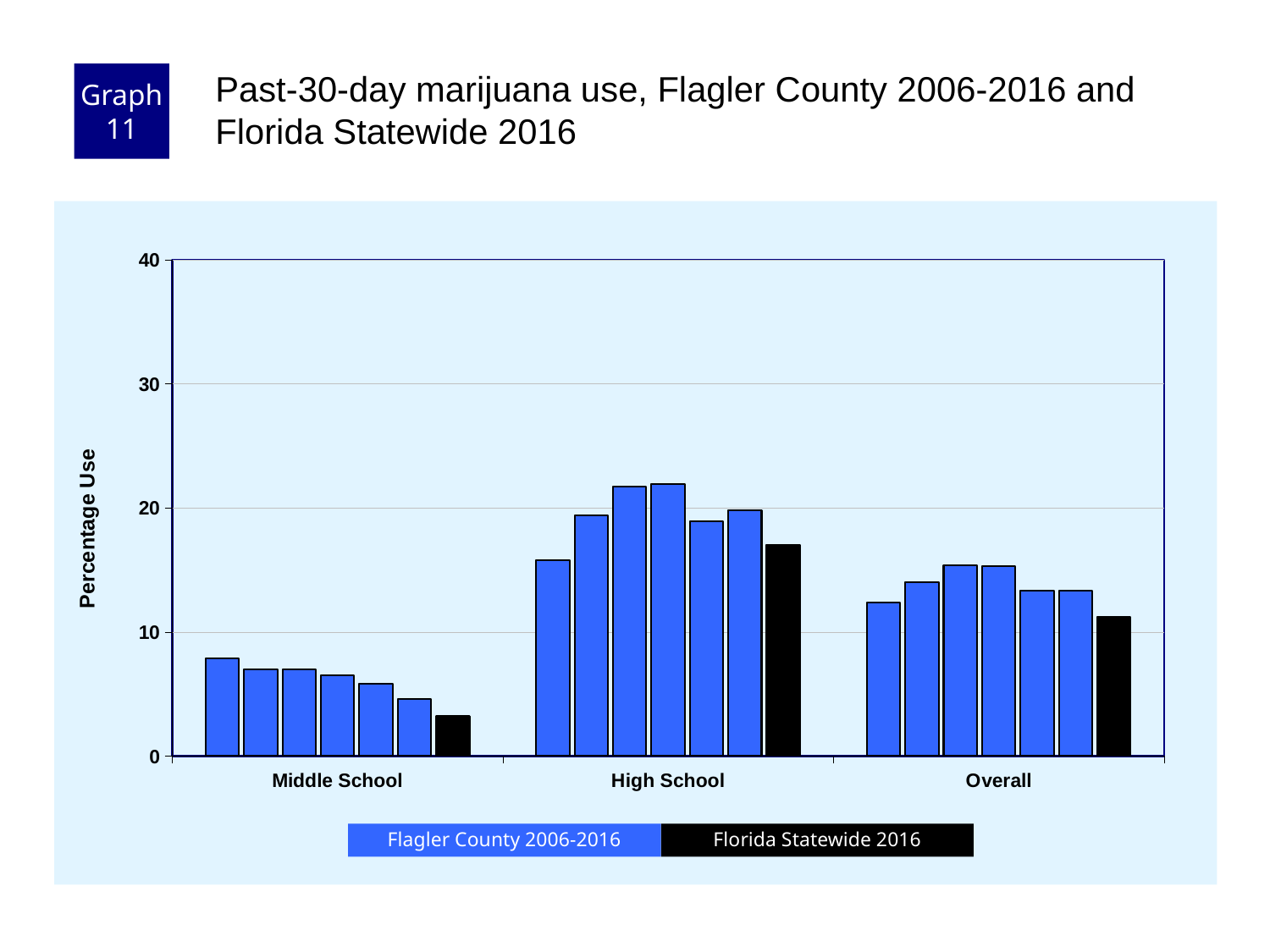
Is the Florida Statewide 2016 value for Middle School greater or less than 10? less How many series does the legend list? 2 Which category has the highest bars overall? High School Is the Florida Statewide 2016 value for High School greater or less than 10? greater What are the two series named in the legend? Flagler County 2006-2016 and Florida Statewide 2016 Do the Flagler County bars for Middle School rise or fall from left to right? fall How many categories are shown on the x axis? 3 Is the Florida Statewide 2016 value for High School greater or less than 20? less Which category has the lowest bars overall? Middle School What kind of chart is shown on the slide? Bar chart Which is larger: the Florida Statewide 2016 value for High School or for Middle School? High School What is the label on the y axis? Percentage Use